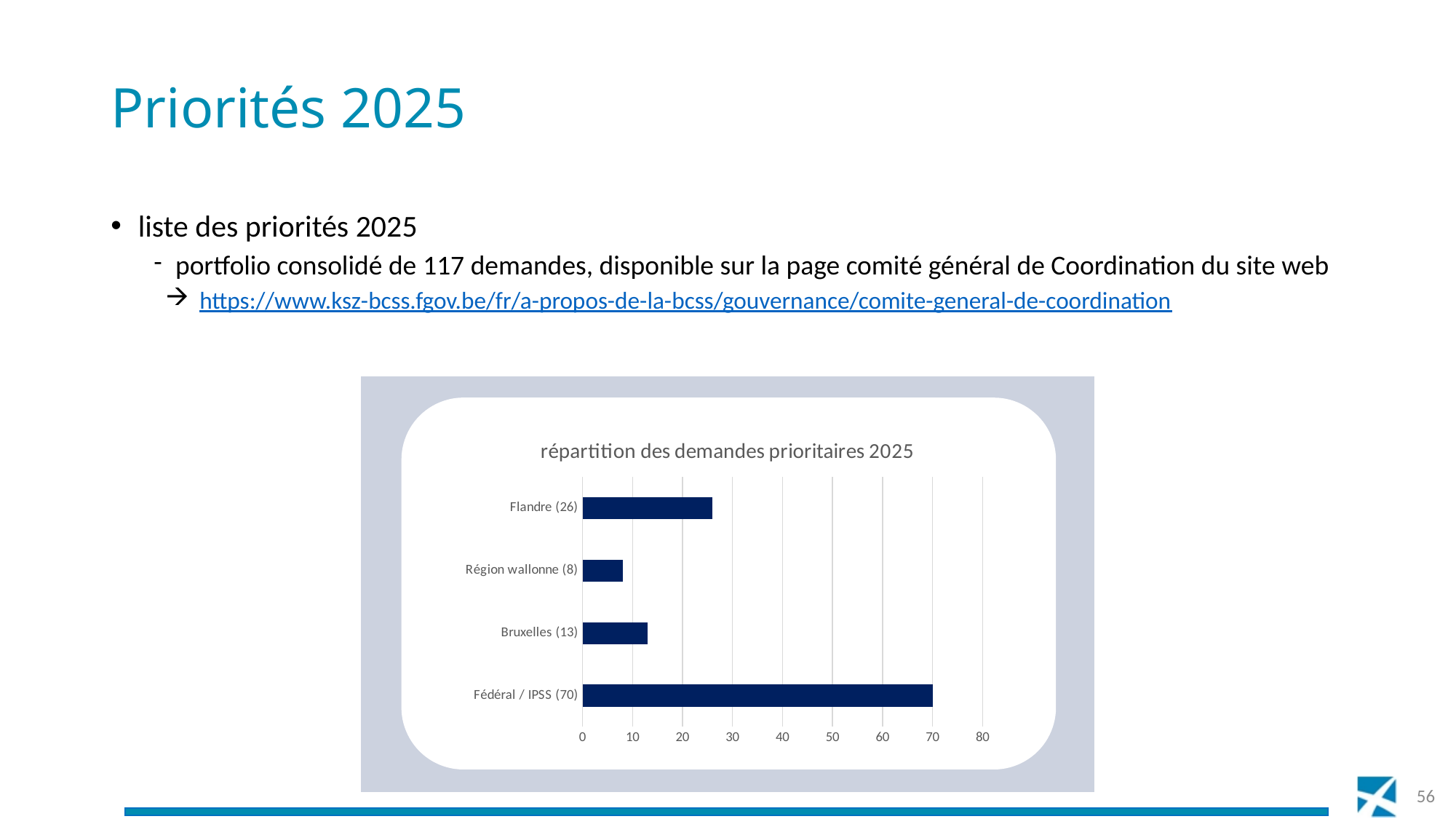
What is the value for Flandre? 26 Is the value for Flandre greater or less than 30? less What is the title of the chart? répartition des demandes prioritaires 2025 Which is larger, the value for Bruxelles or the value for Région wallonne? Bruxelles Which category has the highest value? Fédéral / IPSS What type of chart is shown on the slide? bar chart How many categories does the chart show? 4 What is the value for Région wallonne? 8 What is the difference between the values for Fédéral / IPSS and Flandre? 44 What is the value for Bruxelles? 13 What is the value for Fédéral / IPSS? 70 Which category has the lowest value? Région wallonne